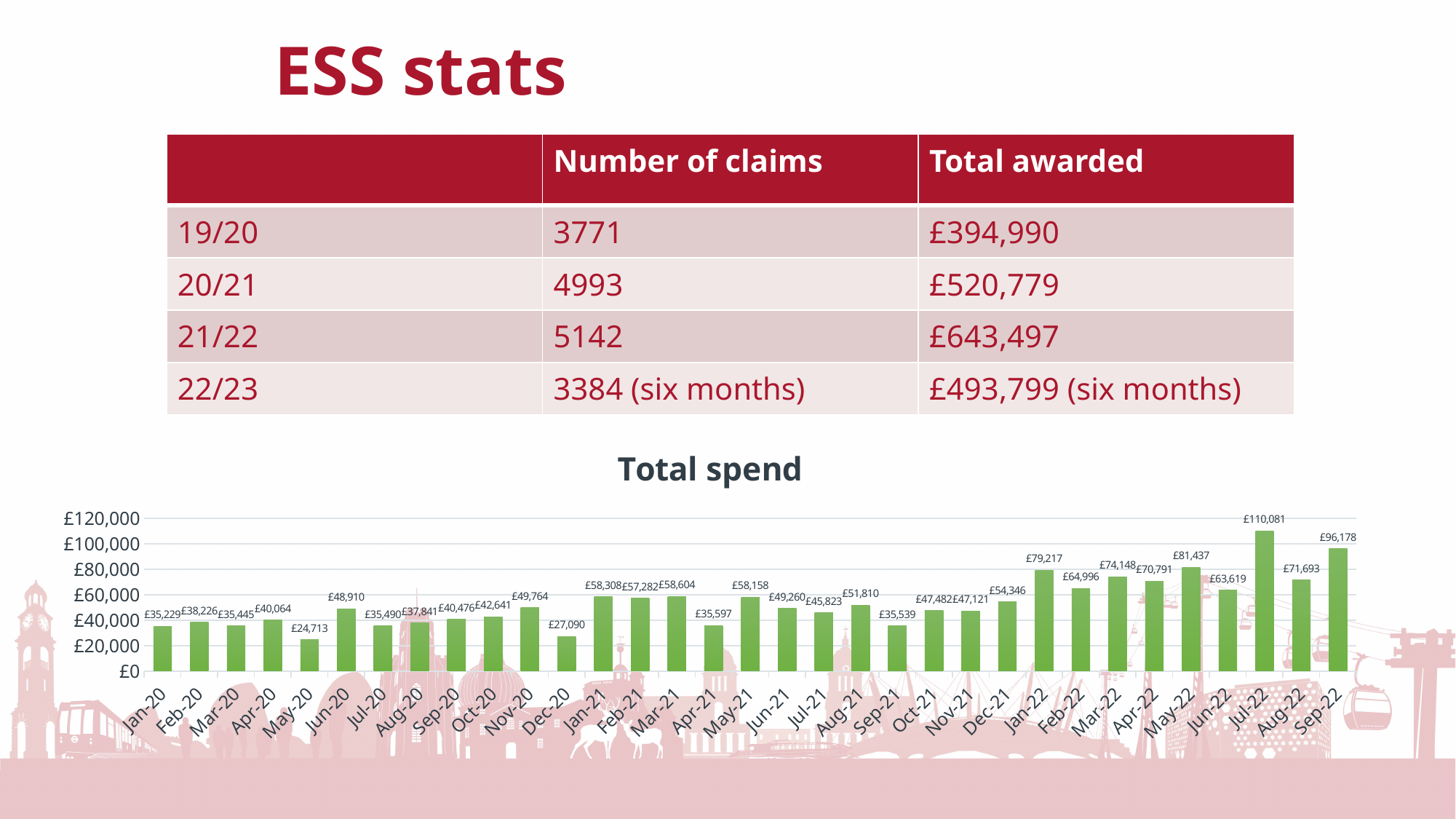
In the "Total spend" chart, what is the difference between the values for Jan-22 and Dec-21? £24,871 In the "Total spend" chart, which month has the lowest total spend? May-20 In the "Total spend" chart, which month has the highest total spend? Jul-22 What type of chart is the "Total spend" chart? bar chart In the "Total spend" chart, what is the value for Dec-20? £27,090 How many months are plotted in the "Total spend" chart? 33 In the "Total spend" chart, which is larger, the value for May-22 or the value for Feb-22? May-22 In the "Total spend" chart, what is the difference between the values for Jul-22 and Sep-22? £13,903 In the "Total spend" chart, is the value for Jul-22 greater or less than £100,000? greater In the "Total spend" chart, what is the value for Sep-22? £96,178 In the "Total spend" chart, what is the value for May-20? £24,713 In the "Total spend" chart, what is the value for Jul-22? £110,081